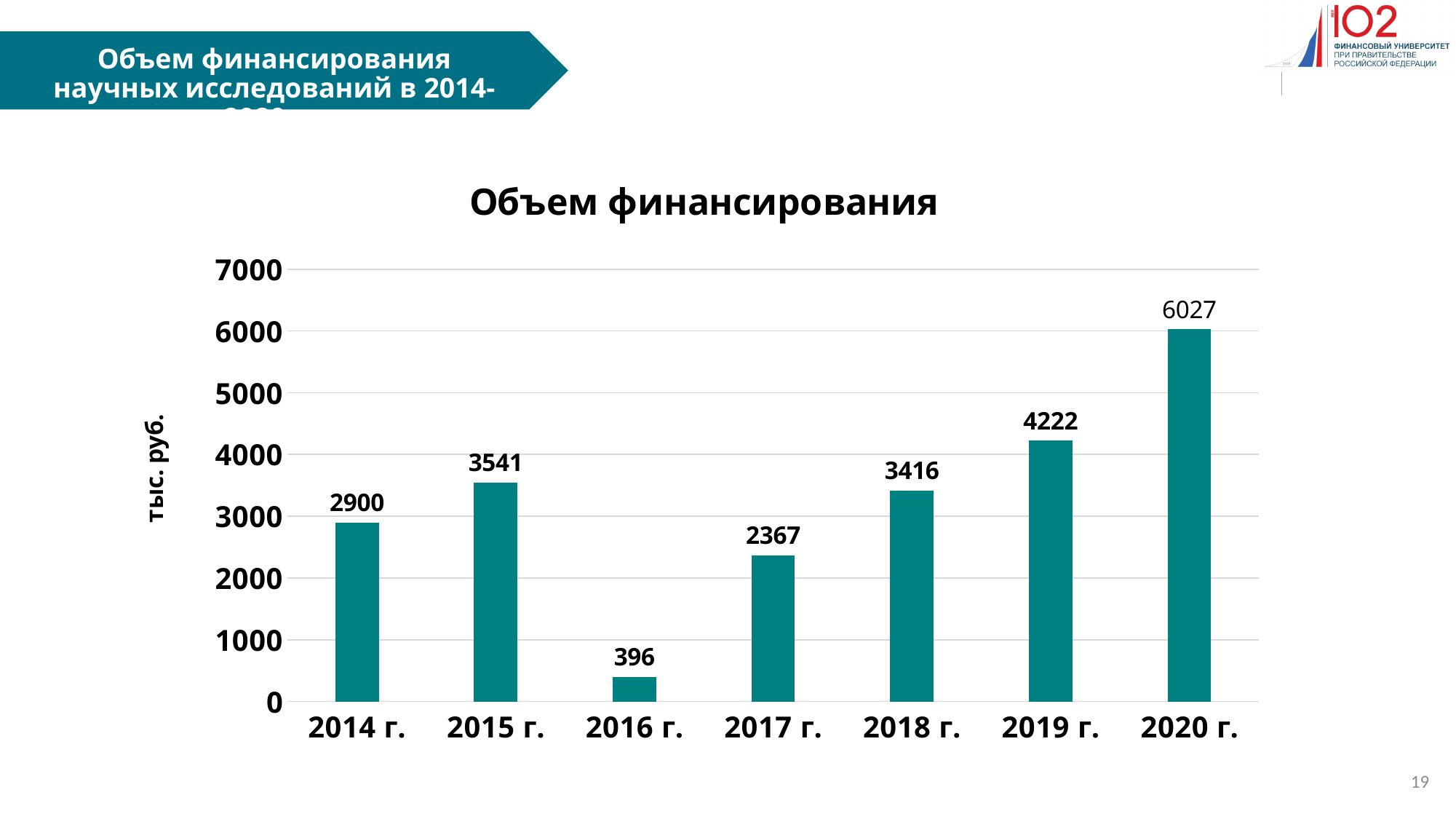
What is the value for 2017 г.? 2367 What is the y-axis label of the chart? тыс. руб. Is the value for 2018 г. greater or less than 3000? greater What is the difference between the values for 2020 г. and 2019 г.? 1805 What is the value for 2019 г.? 4222 Which is larger, the value for 2015 г. or the value for 2018 г.? 2015 г. What is the difference between the values for 2015 г. and 2018 г.? 125 Which year has the highest value? 2020 г. What kind of chart is this? bar chart Which year has the lowest value? 2016 г. How many years are shown on the x axis? 7 What is the value for 2014 г.? 2900